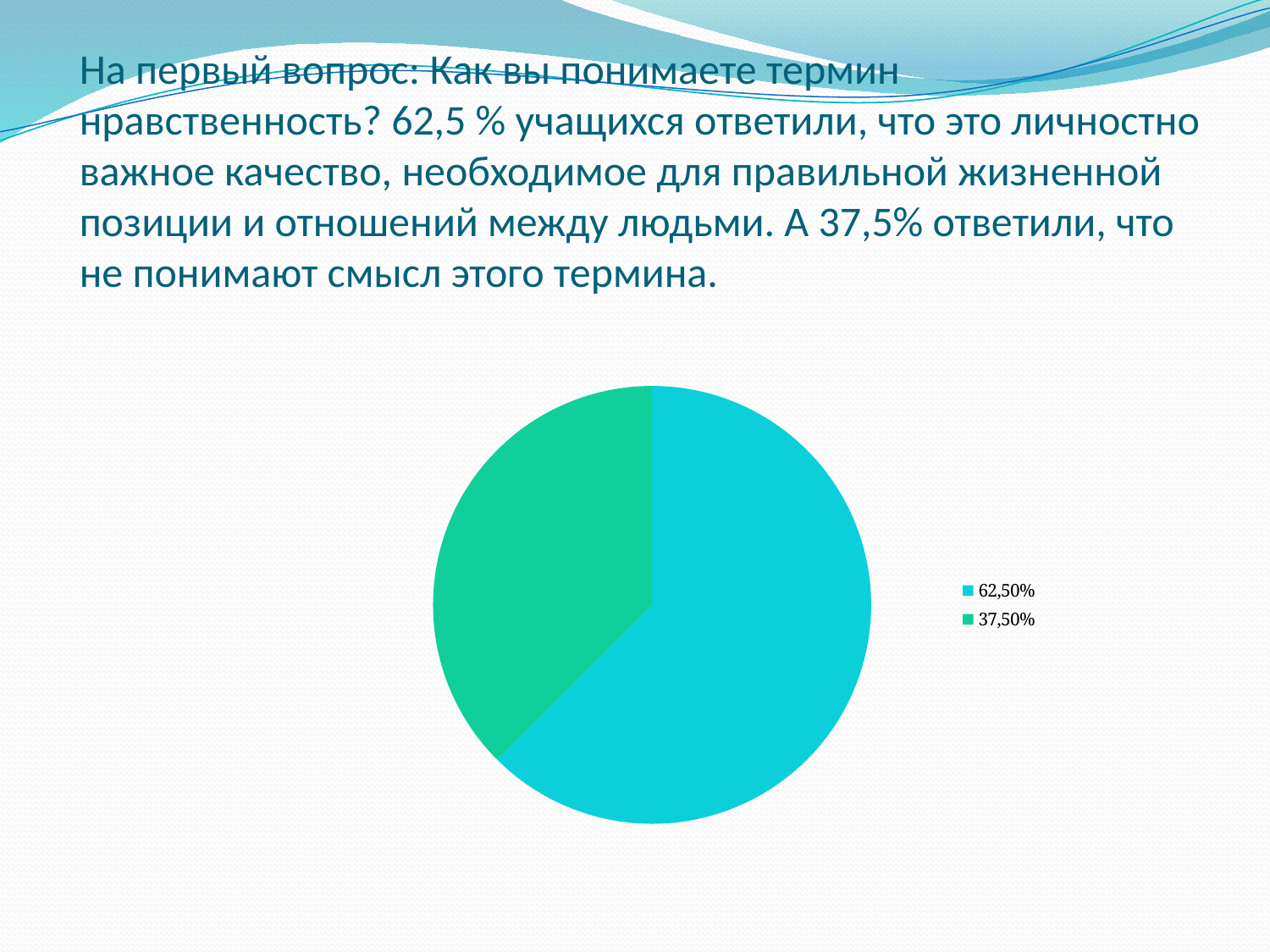
What share of the pie does the green slice represent? 37,50% How many slices does the pie chart have? 2 What colour is the slice labelled 37,50% in the legend? green What share of the pie does the cyan (light blue) slice represent? 62,50% Where is the legend positioned relative to the pie chart? to the right How many entries does the legend of the pie chart list? 2 Which legend entry corresponds to the largest slice of the pie chart? 62,50% Which legend entry corresponds to the smallest slice of the pie chart? 37,50% What kind of chart is shown on the slide? pie chart What is the difference in percentage points between the two slices of the pie chart? 25 Which slice is larger, the cyan slice or the green slice? the cyan slice